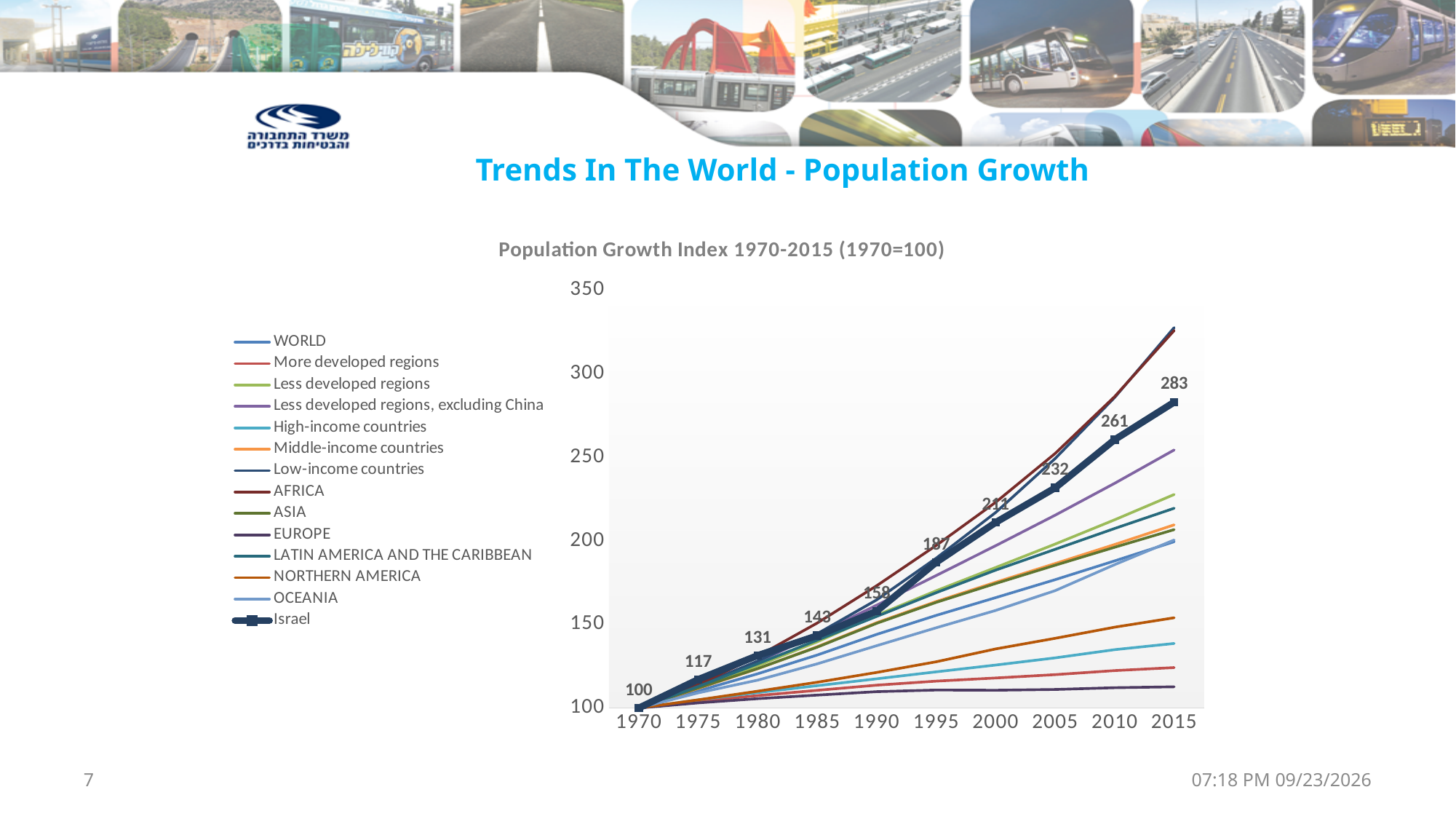
What is the value for Israel in 2015? 283 How many years are shown on the x axis? 10 What kind of chart is shown on the slide? line chart What is the value for Israel in 2010? 261 What is the title of the chart? Population Growth Index 1970-2015 (1970=100) Does the Israel series rise or fall from 1970 to 2015? rises Is the value for EUROPE in 2015 greater or less than 150? less What is the difference between the Israel values for 2015 and 2010? 22 What is the difference between the Israel values for 2005 and 2000? 21 How many series does the legend list? 14 What is the value for Israel in 1980? 131 What is the value for Israel in 1975? 117